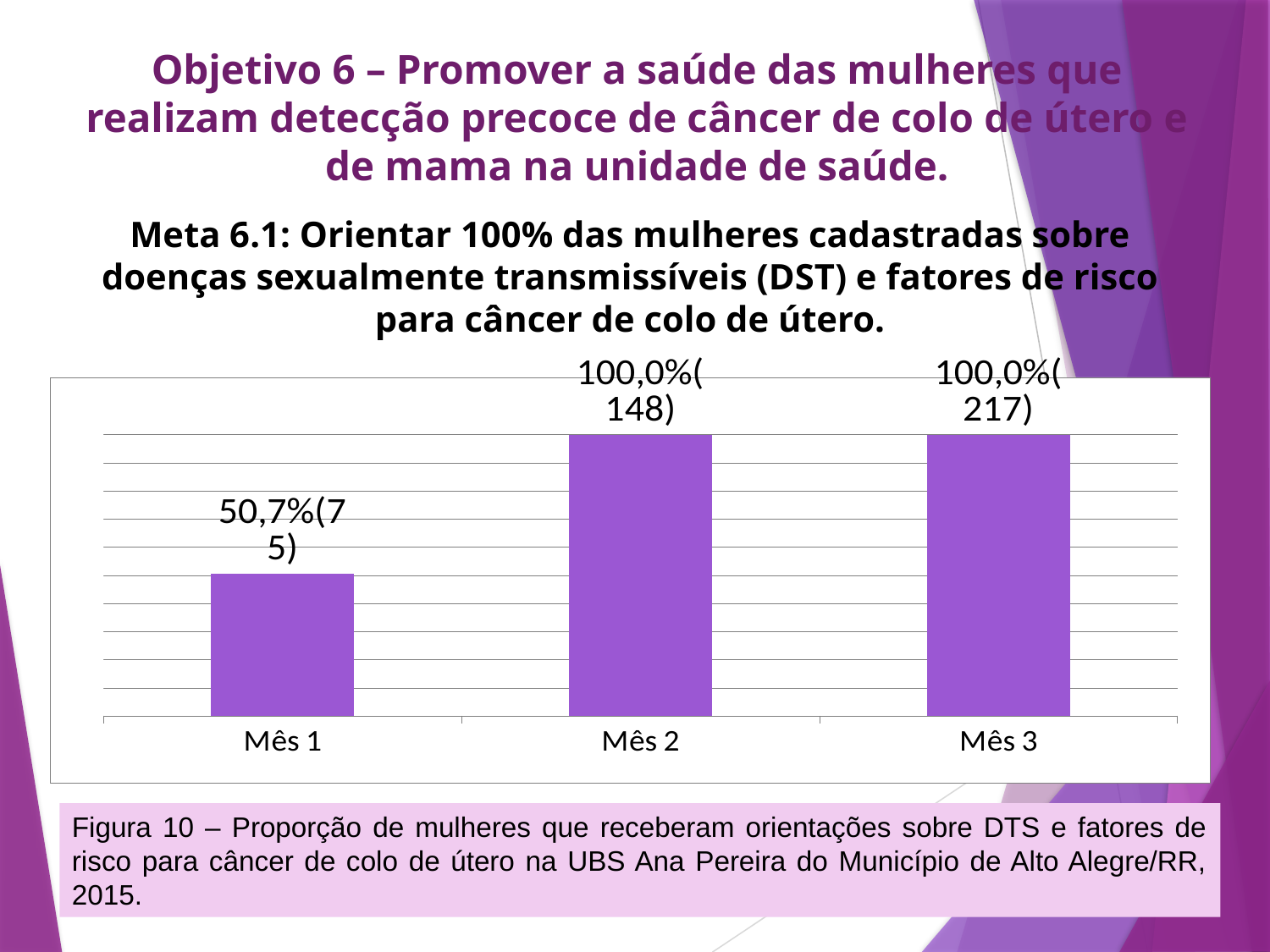
What is the value shown for Mês 3? 100,0%(217) What is the difference in percentage points between Mês 2 and Mês 1? 49,3 Which is larger, the value for Mês 1 or the value for Mês 2? Mês 2 Which month has the lowest proportion? Mês 1 What is the value shown for Mês 2? 100,0%(148) How many months (categories) are shown on the x axis? 3 What is the difference between the number of women in parentheses for Mês 3 and Mês 2? 69 What percentage is shown for Mês 1? 50,7% Do the values rise or fall from Mês 1 to Mês 3? Rise What kind of chart is shown on the slide? Bar chart What is the value shown for Mês 1? 50,7%(75) How many women does the label for Mês 3 show in parentheses? 217